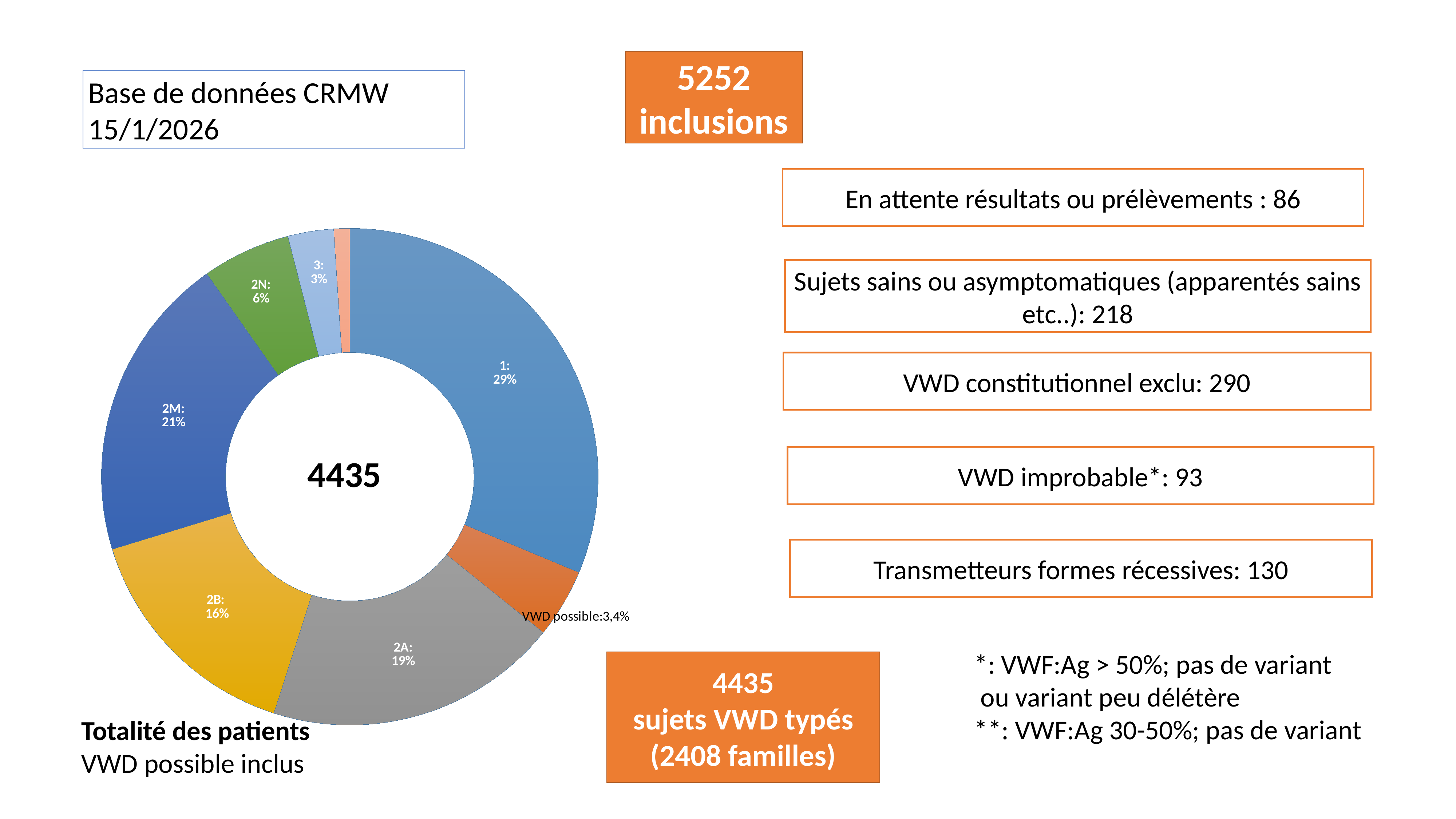
What is the difference in percentage points between type 2A and type 2B? 3 What percentage is shown for type 2A? 19% What percentage is shown for type 2B? 16% Which labelled slice has the largest share of the chart? 1 Which slice is larger, 2M or 2A? 2M What is the difference in percentage points between type 1 and type 2M? 8 What percentage is shown for type 2N? 6% What percentage is shown for type 2M? 21% What percentage is shown for 'VWD possible'? 3,4% What kind of chart is shown on the slide? doughnut chart What number is printed in the centre of the doughnut chart? 4435 What share of the chart does type 1 represent? 29%